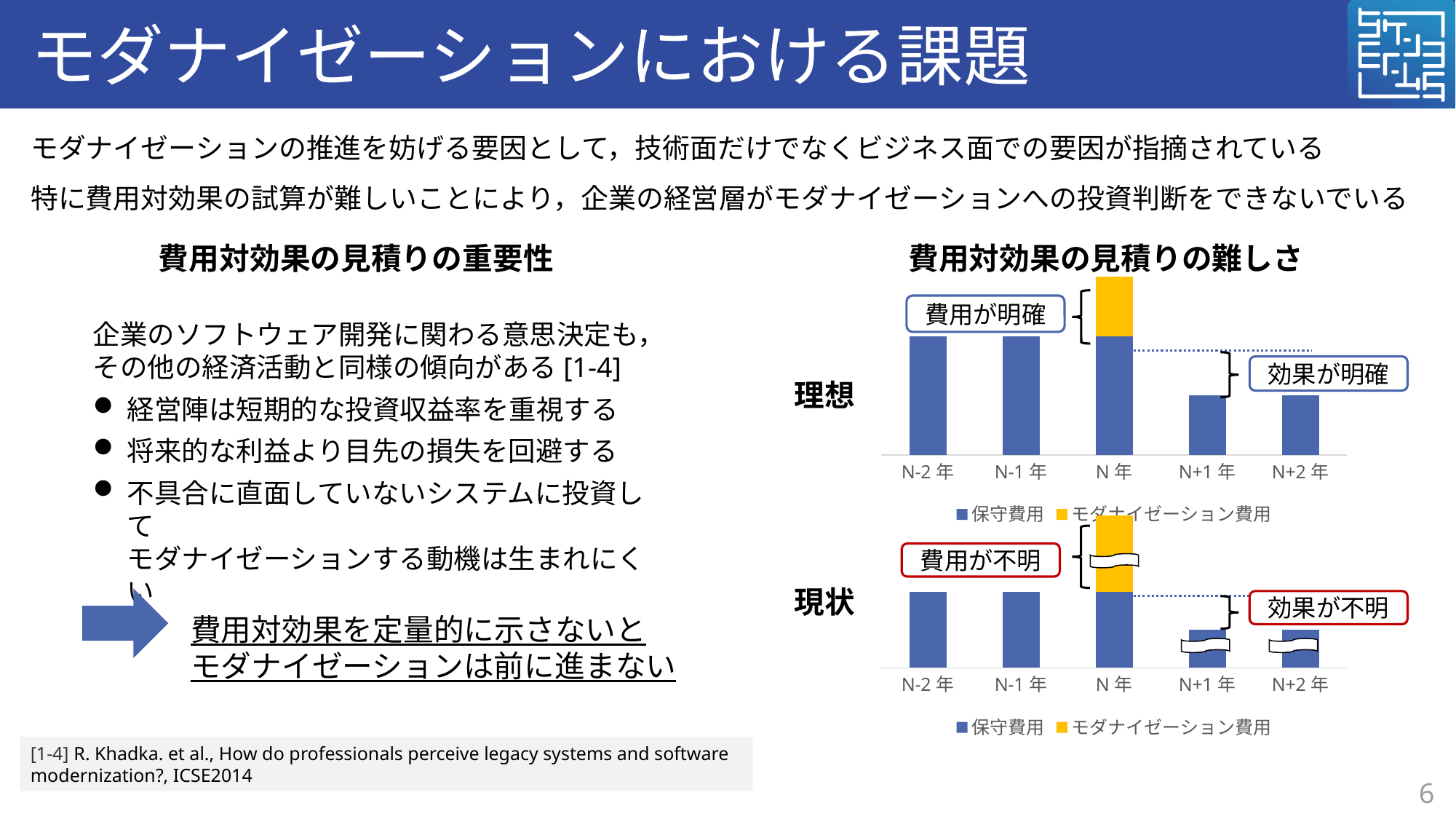
How many categories are shown on the x axis of the bottom chart labelled 現状? 5 In the top chart labelled 理想, which category is the only one that includes the モダナイゼーション費用 segment? N 年 What colour represents モダナイゼーション費用 in the legend of the bottom chart labelled 現状? yellow How many categories are shown on the x axis of the top chart labelled 理想? 5 What kind of chart is the top chart labelled 理想? stacked bar chart In the bottom chart labelled 現状, is the bar for N-1 年 taller or shorter than the bar for N+2 年? taller In the bottom chart labelled 現状, which category has the tallest bar? N 年 In the top chart labelled 理想, is the bar for N-2 年 taller or shorter than the bar for N+1 年? taller What kind of chart is the bottom chart labelled 現状? stacked bar chart In the top chart labelled 理想, which category has the tallest bar? N 年 In the top chart labelled 理想, do the 保守費用 values rise or fall from N 年 to N+2 年? fall How many series does the legend of the top chart labelled 理想 list? 2